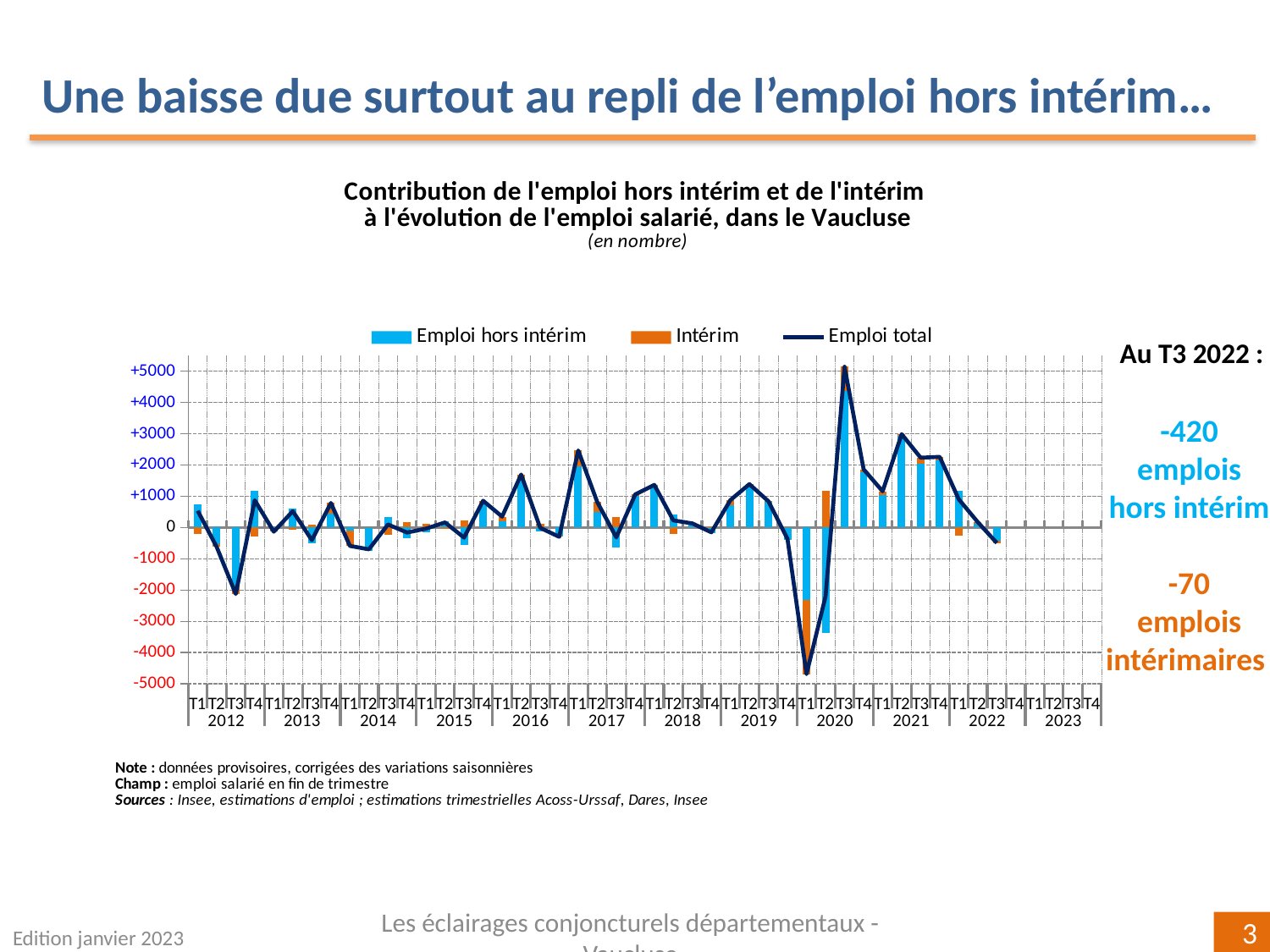
At T3 2022, which contribution is more negative: Emploi hors intérim or Intérim? Emploi hors intérim How many series does the chart legend list? 3 What kind of chart is shown on the slide? combined bar and line chart What is the combined total of the Emploi hors intérim and Intérim contributions at T3 2022? -490 How many years are labelled on the x axis? 12 Is the highest value of the Emploi hors intérim bars in 2020 greater or less than 4000? greater Is the value of Emploi total at T1 2020 greater or less than -4000? less What is the title of the chart? Contribution de l'emploi hors intérim et de l'intérim à l'évolution de l'emploi salarié, dans le Vaucluse According to the annotation, what is the value for Intérim (emplois intérimaires) at T3 2022? -70 In which year does the Emploi total line reach its lowest point? 2020 According to the annotation, what is the value for Emploi hors intérim at T3 2022? -420 What are the three series listed in the chart legend? Emploi hors intérim, Intérim, Emploi total